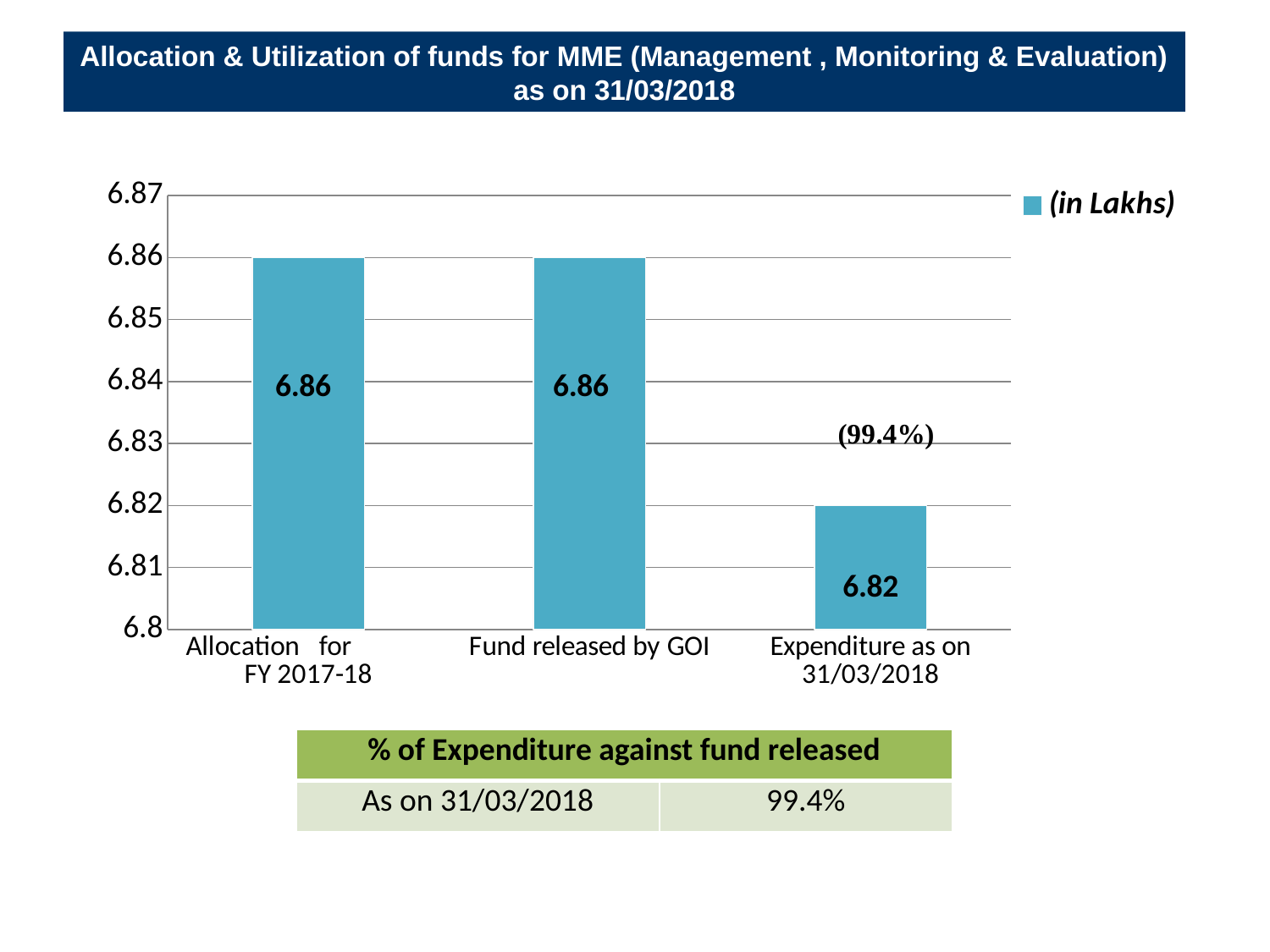
What is the difference between Fund released by GOI and Expenditure as on 31/03/2018? 0.04 What is the legend entry for the series? (in Lakhs) Is the value for Expenditure as on 31/03/2018 greater or less than 6.83? less What is the value for Allocation for FY 2017-18? 6.86 What percentage is printed above the Expenditure as on 31/03/2018 bar? (99.4%) What is the value for Fund released by GOI? 6.86 Which is larger, Allocation for FY 2017-18 or Expenditure as on 31/03/2018? Allocation for FY 2017-18 What kind of chart is shown? bar chart What is the value for Expenditure as on 31/03/2018? 6.82 How many series does the legend list? 1 Which category has the lowest value? Expenditure as on 31/03/2018 How many categories are shown on the x axis? 3